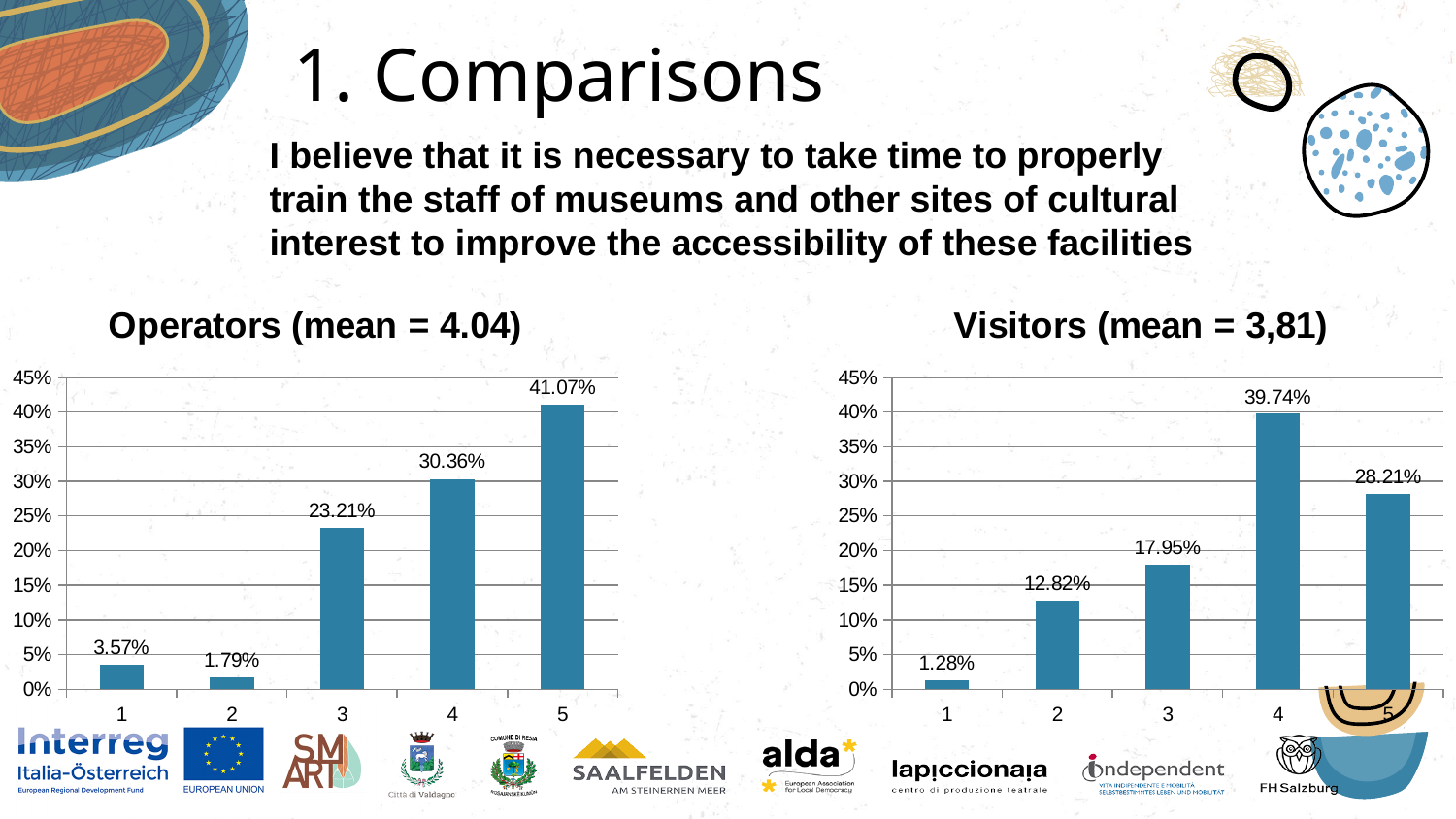
In the Visitors chart, what is the value for category 2? 12.82% In the Visitors chart, which category has the highest value? 4 In the Operators chart, what is the difference between the values for category 5 and category 4? 10.71% In the Visitors chart, which category has the lowest value? 1 In the Operators chart, which category has the lowest value? 2 How many categories are shown on the x axis of the Visitors chart? 5 What kind of chart is the Operators chart? bar chart In the Operators chart, is the value for category 4 greater or less than 25%? greater In the Visitors chart, which is larger: the value for category 4 or category 5? 4 In the Operators chart, what is the value for category 5? 41.07% What is the mean value stated in the title of the Visitors chart? 3,81 In the Operators chart, what is the value for category 3? 23.21%